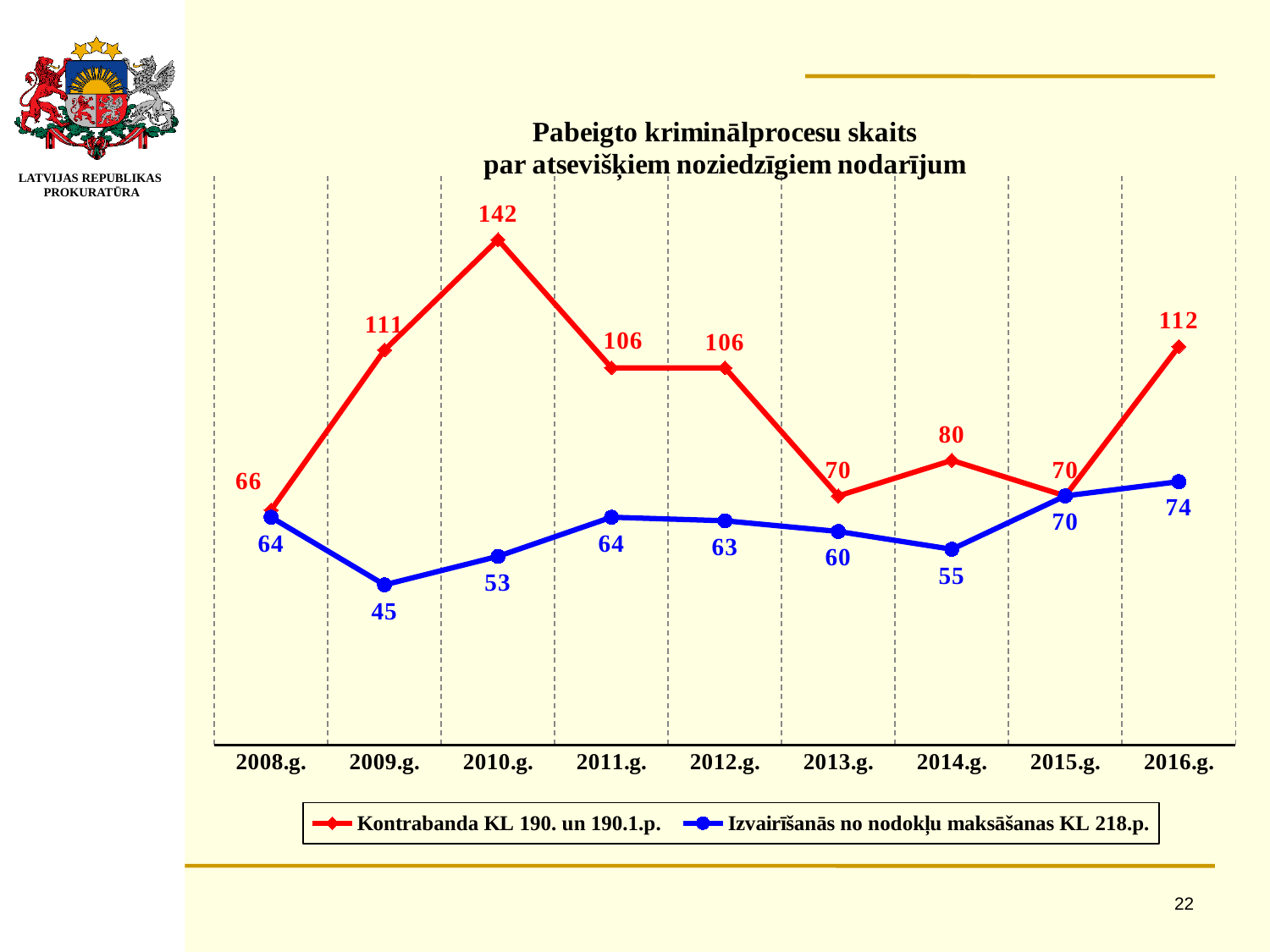
Which series has the larger value in 2015.g., or are they equal? They are equal (70) How many years are shown on the x axis? 9 Does the Kontrabanda KL 190. un 190.1.p. series rise or fall from 2010.g. to 2013.g.? Fall In which year does the Kontrabanda KL 190. un 190.1.p. series reach its highest value? 2010.g. What is the value for Kontrabanda KL 190. un 190.1.p. in 2016.g.? 112 What is the difference between the Kontrabanda KL 190. un 190.1.p. value and the Izvairīšanās no nodokļu maksāšanas KL 218.p. value in 2010.g.? 89 What kind of chart is shown on the slide? Line chart Which series has the larger value in 2014.g.? Kontrabanda KL 190. un 190.1.p. How many series does the legend list? 2 What is the value for Izvairīšanās no nodokļu maksāšanas KL 218.p. in 2009.g.? 45 What is the value for Kontrabanda KL 190. un 190.1.p. in 2010.g.? 142 In which year does the Izvairīšanās no nodokļu maksāšanas KL 218.p. series have its lowest value? 2009.g.